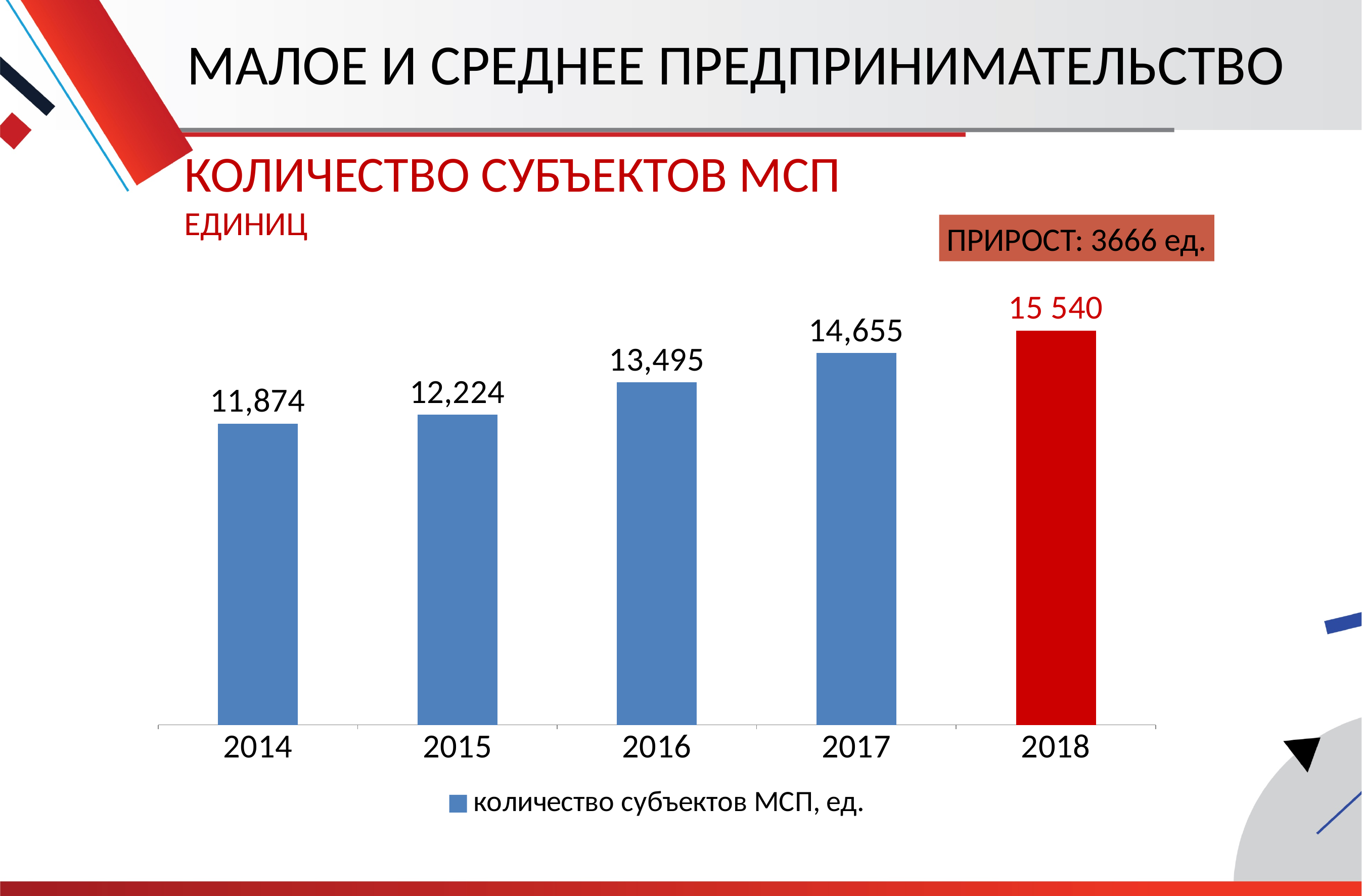
Which year has the lowest value? 2014 How many series does the legend list? 1 What is the value for 2014? 11,874 What is the difference between the values for 2017 and 2016? 1,160 How many years are shown on the x axis? 5 What is the value for 2016? 13,495 What kind of chart is shown? bar chart What is the difference between the values for 2015 and 2014? 350 What is the value for 2018? 15 540 Which is larger, the value for 2017 or the value for 2015? 2017 Do the values rise or fall from 2014 to 2018? rise Which year has the highest value? 2018